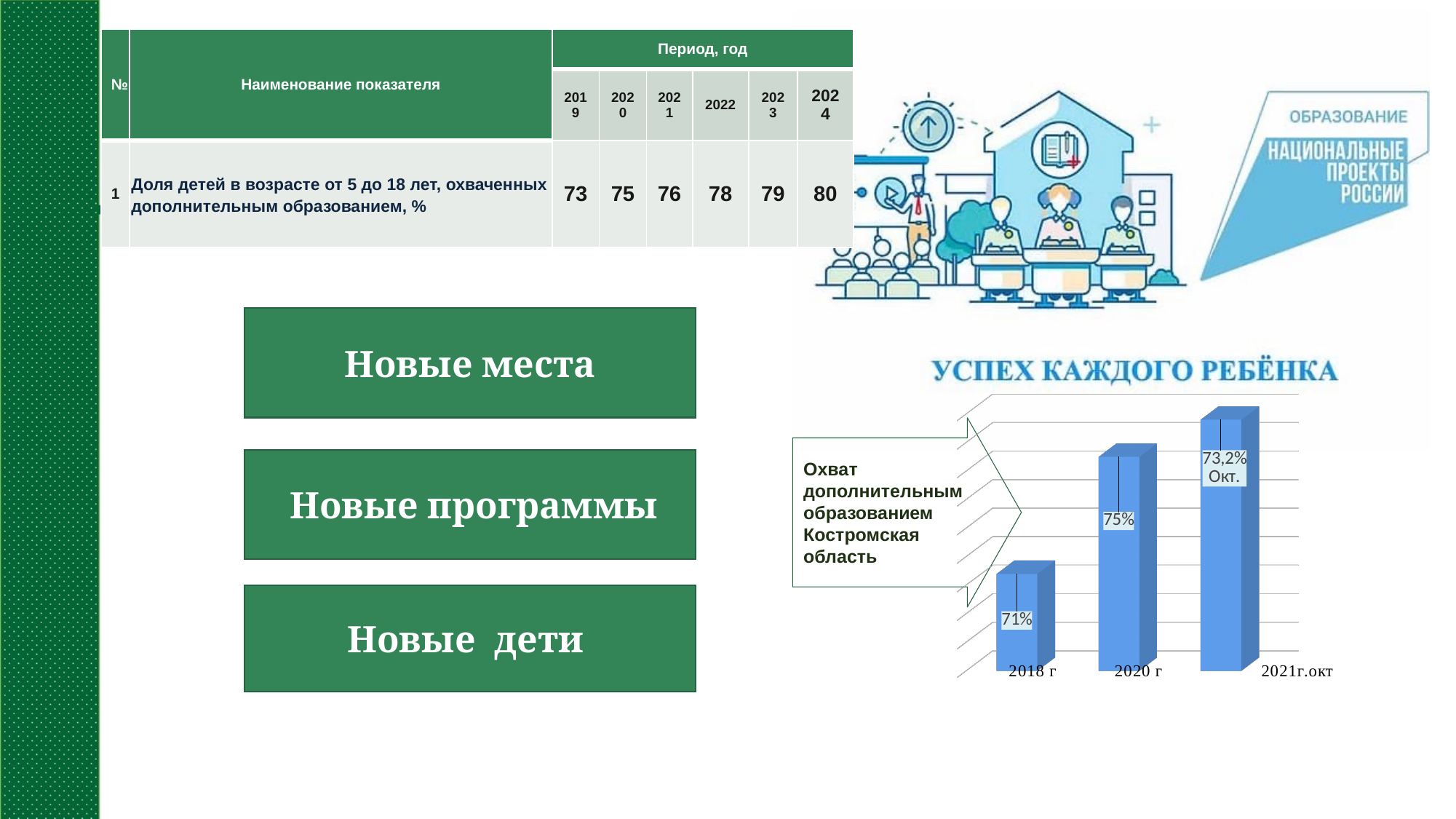
Does the value rise or fall from 2018 г to 2020 г in the bar chart? Rise What is the label of the last category on the x axis of the bar chart? 2021г.окт Which year has the lowest value in the bar chart? 2018 г What kind of chart is shown on the slide? Bar chart By how many percentage points does the 2020 г value exceed the 2018 г value in the bar chart? 4 What is the value shown for 2018 г in the bar chart? 71% What value is labelled on the bar for 2021г.окт in the chart? 73,2% How many bars are shown in the chart? 3 What is the value shown for 2020 г in the bar chart? 75% Which is larger in the bar chart, the value for 2018 г or the value for 2020 г? 2020 г What is the title shown above the bar chart? УСПЕХ КАЖДОГО РЕБЁНКА